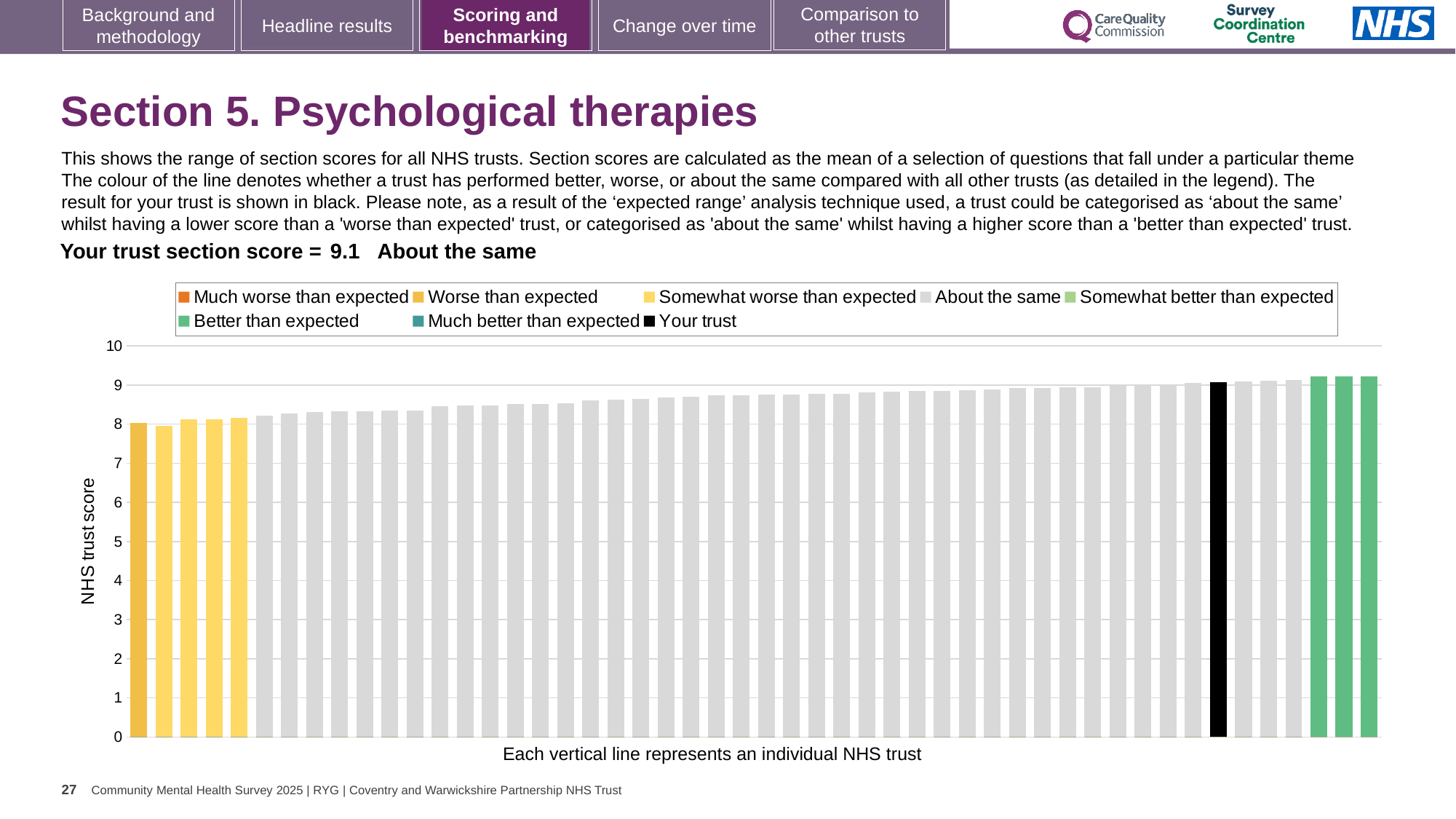
What kind of chart is used to show the NHS trust scores? bar chart What is the section score for your trust shown on the slide? 9.1 Which legend category do the highest-scoring trusts on the chart belong to? Better than expected Which is larger: the score for your trust (black bar) or the score for the leftmost trust bar? your trust How many bars are coloured green (better than expected)? 3 Is the value for the leftmost trust bar greater or less than 9? less What is the label on the vertical axis of the chart? NHS trust score Which category is your trust placed in for this section? About the same Do the trust scores rise or fall moving from left to right along the x axis? rise How many entries does the chart legend list? 8 What does each vertical line in the chart represent, according to the caption below the x axis? an individual NHS trust